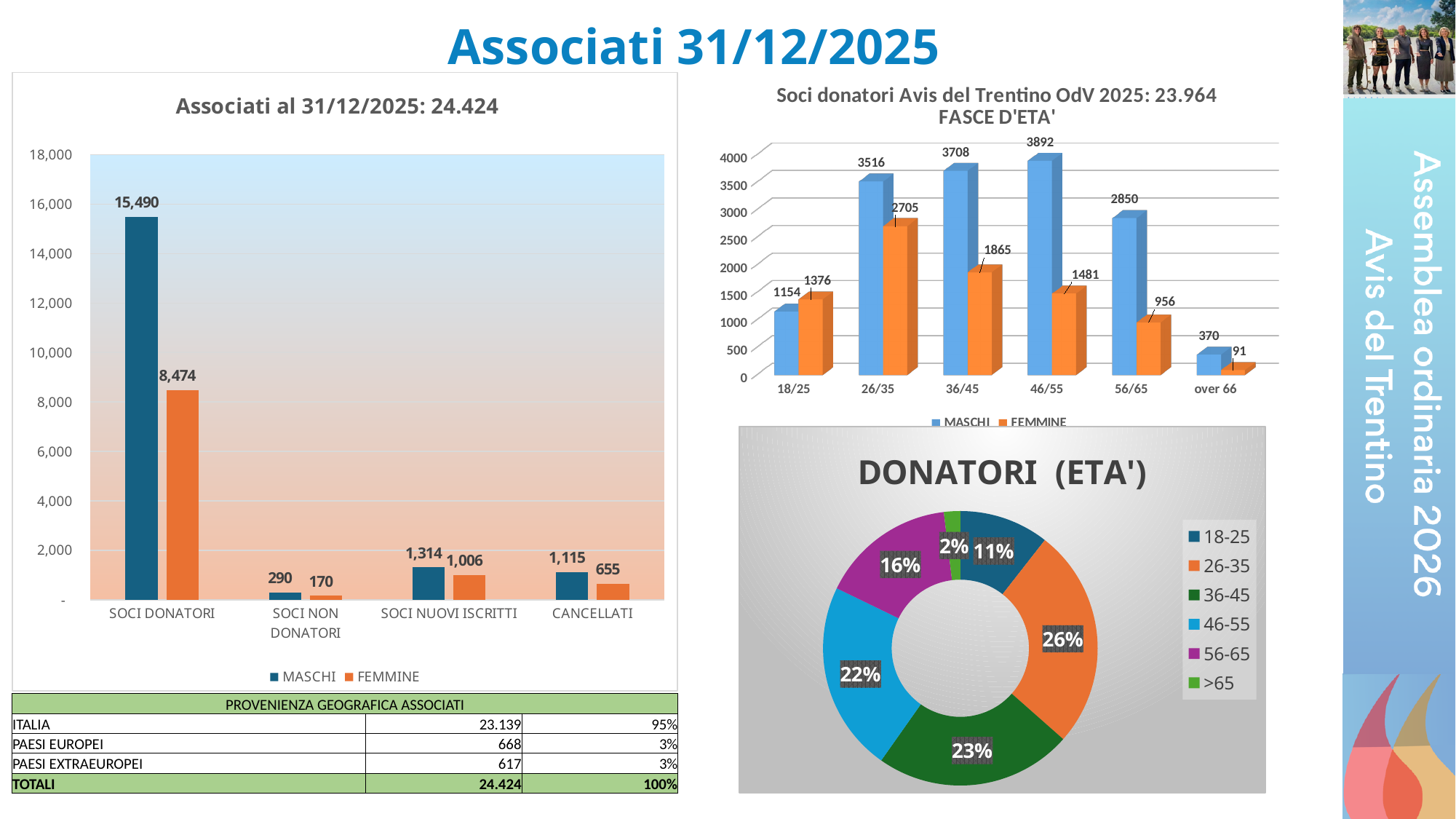
How many categories are shown on the x axis of the chart titled 'Associati al 31/12/2025: 24.424'? 4 In the chart titled 'DONATORI (ETA')', what share does the 46-55 age group have? 22% How many series does the legend list in the chart titled 'Soci donatori Avis del Trentino OdV 2025: 23.964 FASCE D'ETA''? 2 In the chart titled 'Associati al 31/12/2025: 24.424', what is the difference between MASCHI and FEMMINE in the SOCI NUOVI ISCRITTI category? 308 In the chart titled 'Soci donatori Avis del Trentino OdV 2025: 23.964 FASCE D'ETA'', what is the difference between MASCHI and FEMMINE in the 56/65 age group? 1894 In the chart titled 'Associati al 31/12/2025: 24.424', what is the value for MASCHI in the SOCI DONATORI category? 15,490 In the chart titled 'Soci donatori Avis del Trentino OdV 2025: 23.964 FASCE D'ETA'', what is the MASCHI value for the 46/55 age group? 3892 What kind of chart is the one titled 'DONATORI (ETA')'? doughnut chart In the chart titled 'Associati al 31/12/2025: 24.424', which category has the lowest FEMMINE value? SOCI NON DONATORI In the chart titled 'Soci donatori Avis del Trentino OdV 2025: 23.964 FASCE D'ETA'', which age group has the highest FEMMINE value? 26/35 In the chart titled 'Associati al 31/12/2025: 24.424', what is the value for FEMMINE in the CANCELLATI category? 655 In the chart titled 'Soci donatori Avis del Trentino OdV 2025: 23.964 FASCE D'ETA'', is the MASCHI value for 18/25 larger or smaller than the FEMMINE value for 18/25? smaller